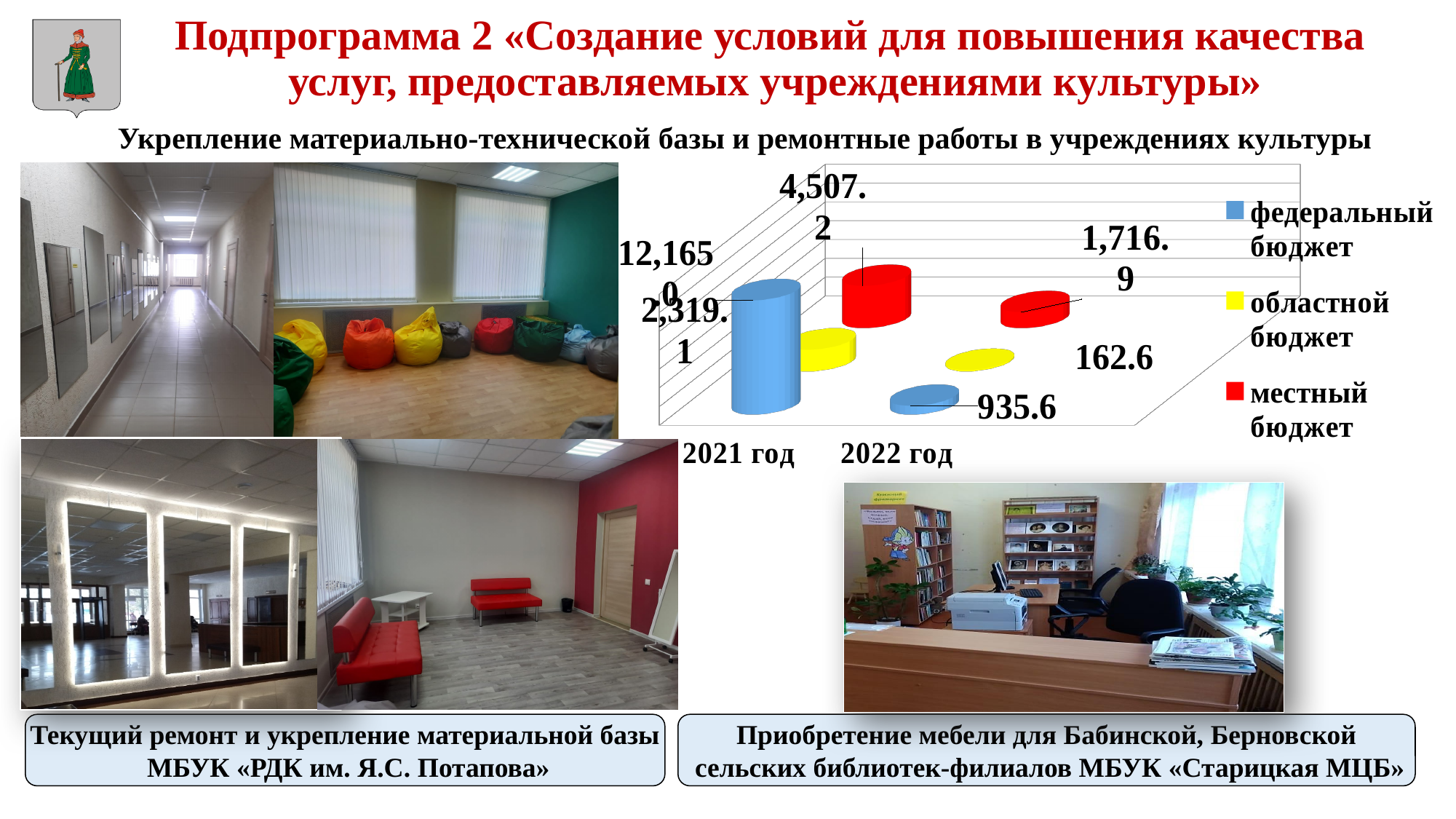
What is the value for местный бюджет in 2021 год? 4,507.2 How many series does the chart legend list? 3 By how much does местный бюджет in 2021 год exceed местный бюджет in 2022 год? 2,790.3 What kind of chart is shown on the slide? bar chart Which budget series has the lowest value in 2022 год? областной бюджет How many year categories are shown on the chart's x axis? 2 Which year has the larger value for областной бюджет, 2021 год or 2022 год? 2021 год Which budget series has the highest value in 2021 год? федеральный бюджет What is the value for областной бюджет in 2021 год? 2,319.1 What is the value for областной бюджет in 2022 год? 162.6 What is the value for местный бюджет in 2022 год? 1,716.9 What is the value for федеральный бюджет in 2022 год? 935.6